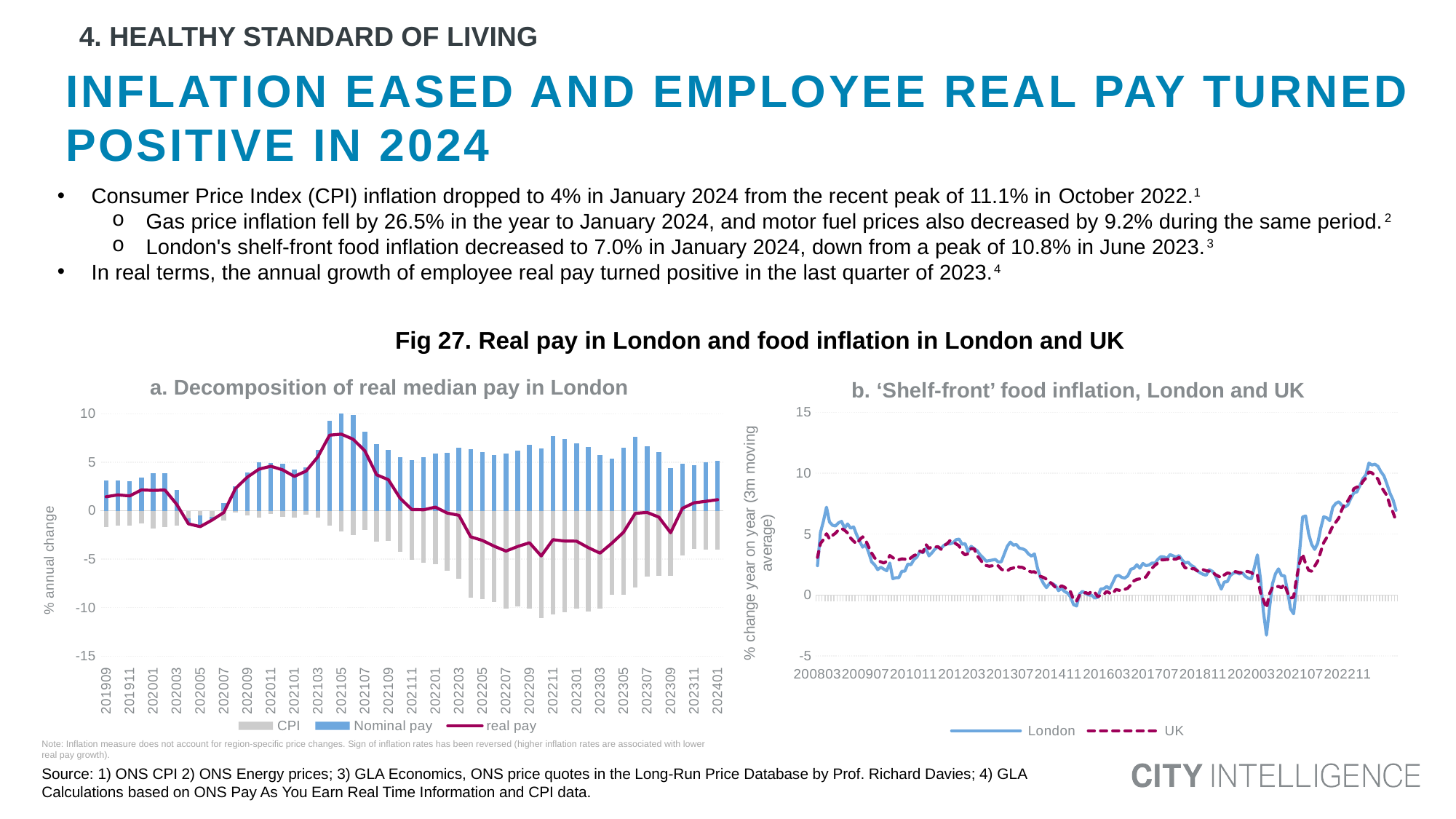
In chart b ('Shelf-front' food inflation, London and UK), how many series does the legend list? 2 In chart b, do the values for London rise or fall between 202107 and 202211? rise In chart a, at 202105, which is larger: Nominal pay or real pay? Nominal pay What kind of chart is chart b ('Shelf-front' food inflation, London and UK)? Line chart In chart a, is the CPI value for 202211 greater or less than -5? less In chart b, which series reaches the lowest value on the chart? London What kind of chart is chart a (Decomposition of real median pay in London)? Combined bar and line chart In chart b, is the London value at its lowest point (around 202003) greater or less than 0? less In chart a (Decomposition of real median pay in London), how many series does the legend list? 3 What is the y-axis label of chart a (Decomposition of real median pay in London)? % annual change In chart a, is the real pay value for 202303 greater or less than 0? less